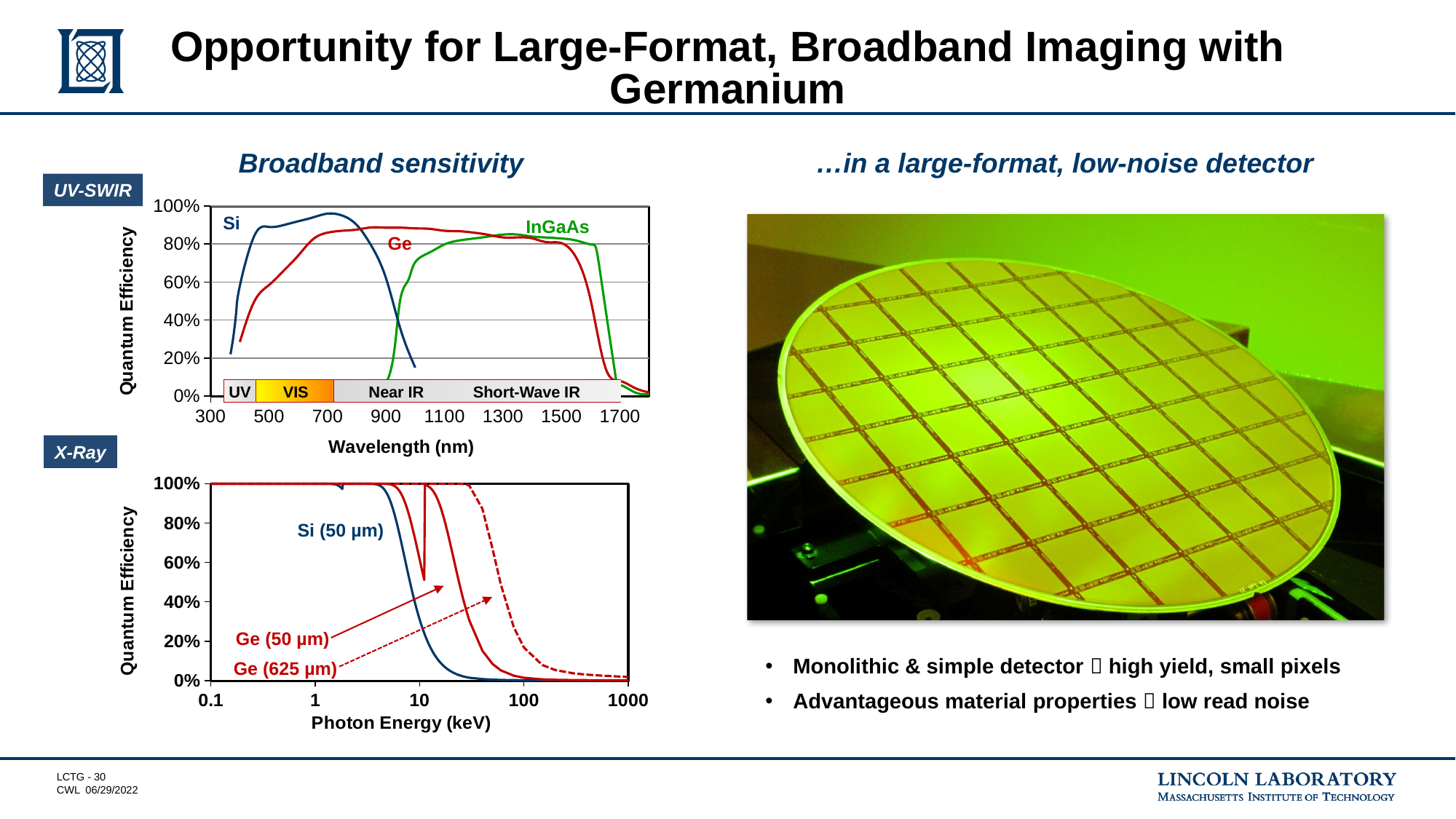
How many labelled curves does the X-Ray chart (Quantum Efficiency vs Photon Energy) show? 3 In the UV-SWIR chart, does the Si curve rise or fall between 700 nm and 1000 nm? Fall In the UV-SWIR chart, is the quantum efficiency of Si at 1000 nm greater or less than 40%? less In the UV-SWIR chart, which curve is drawn in green? InGaAs How many labelled curves does the UV-SWIR chart show? 3 In the X-Ray chart, which has the higher quantum efficiency at 100 keV, Ge (625 µm) or Si (50 µm)? Ge (625 µm) In the UV-SWIR chart, is the quantum efficiency of Ge at 1100 nm greater or less than 80%? greater In the UV-SWIR chart, is the quantum efficiency of Si at 700 nm greater or less than 80%? greater What kind of chart is the UV-SWIR chart (Quantum Efficiency vs Wavelength)? Line chart In the UV-SWIR chart, which has the higher quantum efficiency at 400 nm, Si or Ge? Si